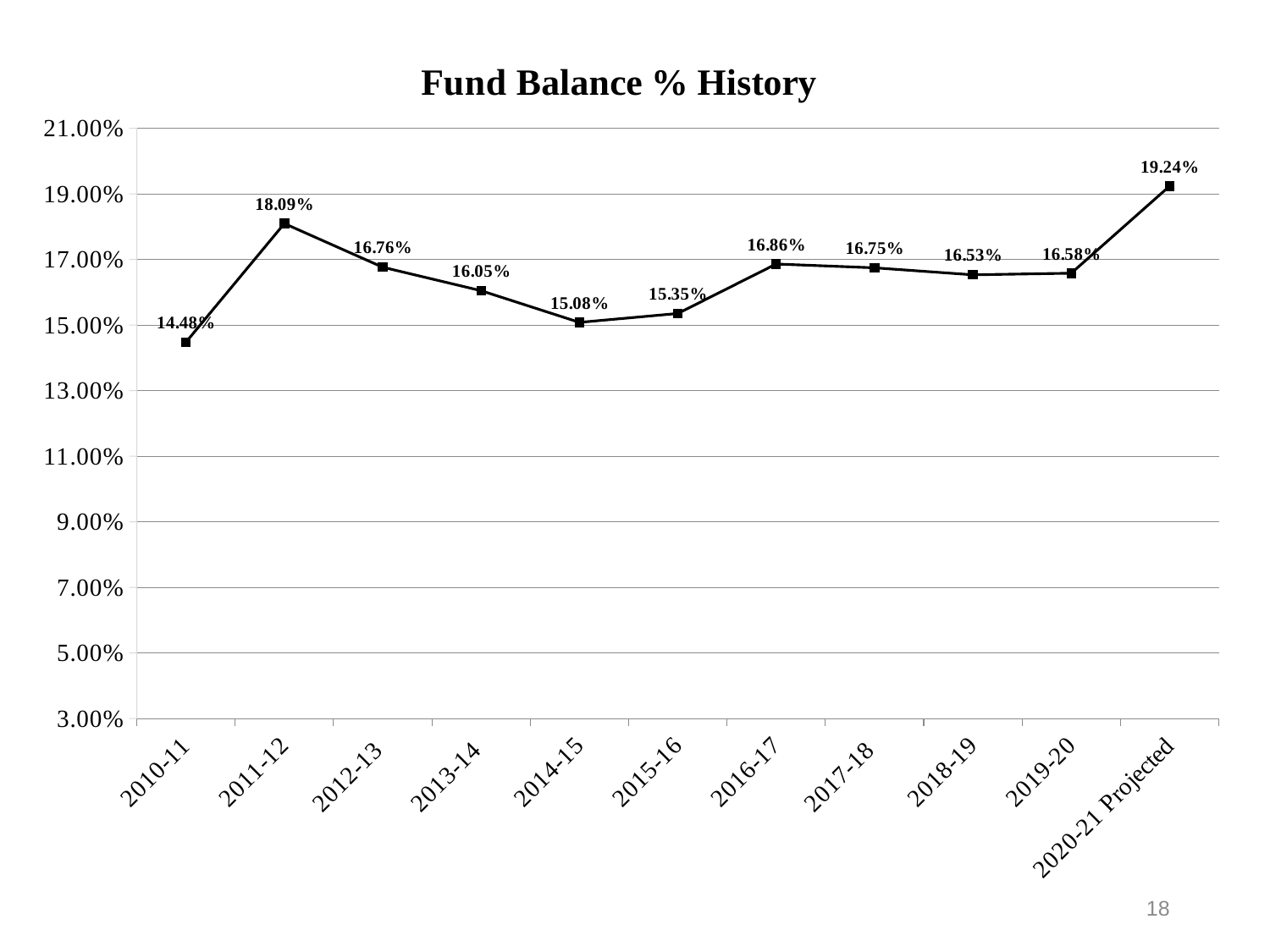
Does the fund balance % rise or fall from 2011-12 to 2014-15? fall Which year has the lowest fund balance %? 2010-11 What is the fund balance % for 2020-21 Projected? 19.24% What is the title of the chart? Fund Balance % History How many years are plotted on the chart? 11 What kind of chart is shown? line chart What is the difference between the fund balance % for 2011-12 and 2010-11? 3.61% Which is larger, the fund balance % for 2016-17 or 2015-16? 2016-17 Is the fund balance % for 2013-14 greater or less than 15.00%? greater What is the fund balance % for 2014-15? 15.08% Which year has the highest fund balance %? 2020-21 Projected What is the fund balance % for 2010-11? 14.48%